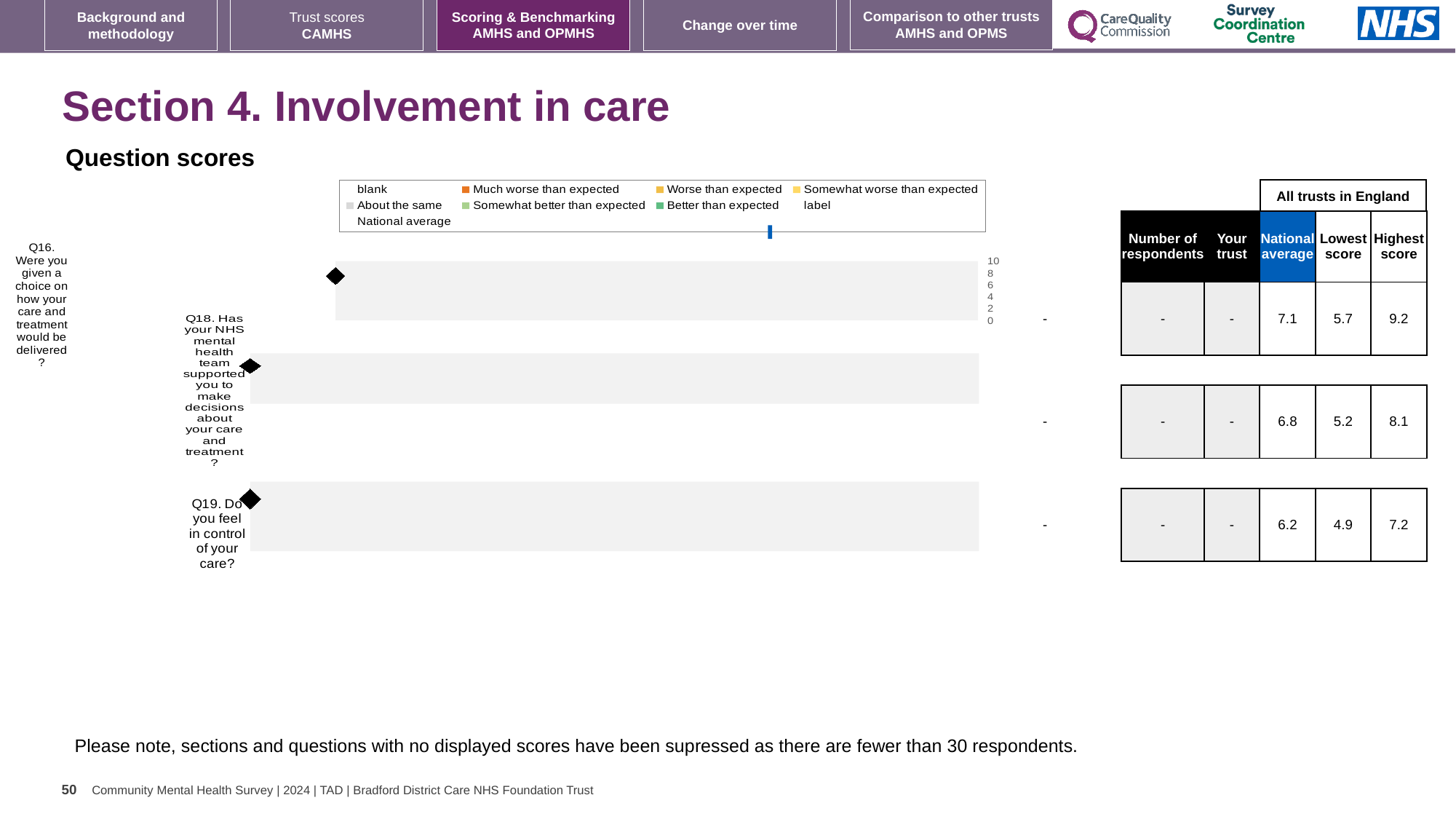
What is the highest tick value shown on the chart's numeric axis? 10 According to the table, which question has the lowest National average? Q19 According to the table, which question has the highest National average? Q16 According to the table, which has the larger National average: Q18 or Q19? Q18 How many questions (categories) are listed on the chart's vertical axis? 3 What is the heading above the chart? Question scores According to the table, what is the difference between the Highest score and the Lowest score for Q16? 3.5 In the table beside the chart, what is shown in the 'Your trust' column for Q16? - In the table beside the chart, what is the Highest score for Q18 (NHS mental health team supported you to make decisions)? 8.1 What kind of chart is shown under 'Question scores'? bar chart In the table beside the chart, what is the National average for Q16 (choice on how care and treatment would be delivered)? 7.1 In the table beside the chart, what is the Lowest score for Q19 (Do you feel in control of your care)? 4.9